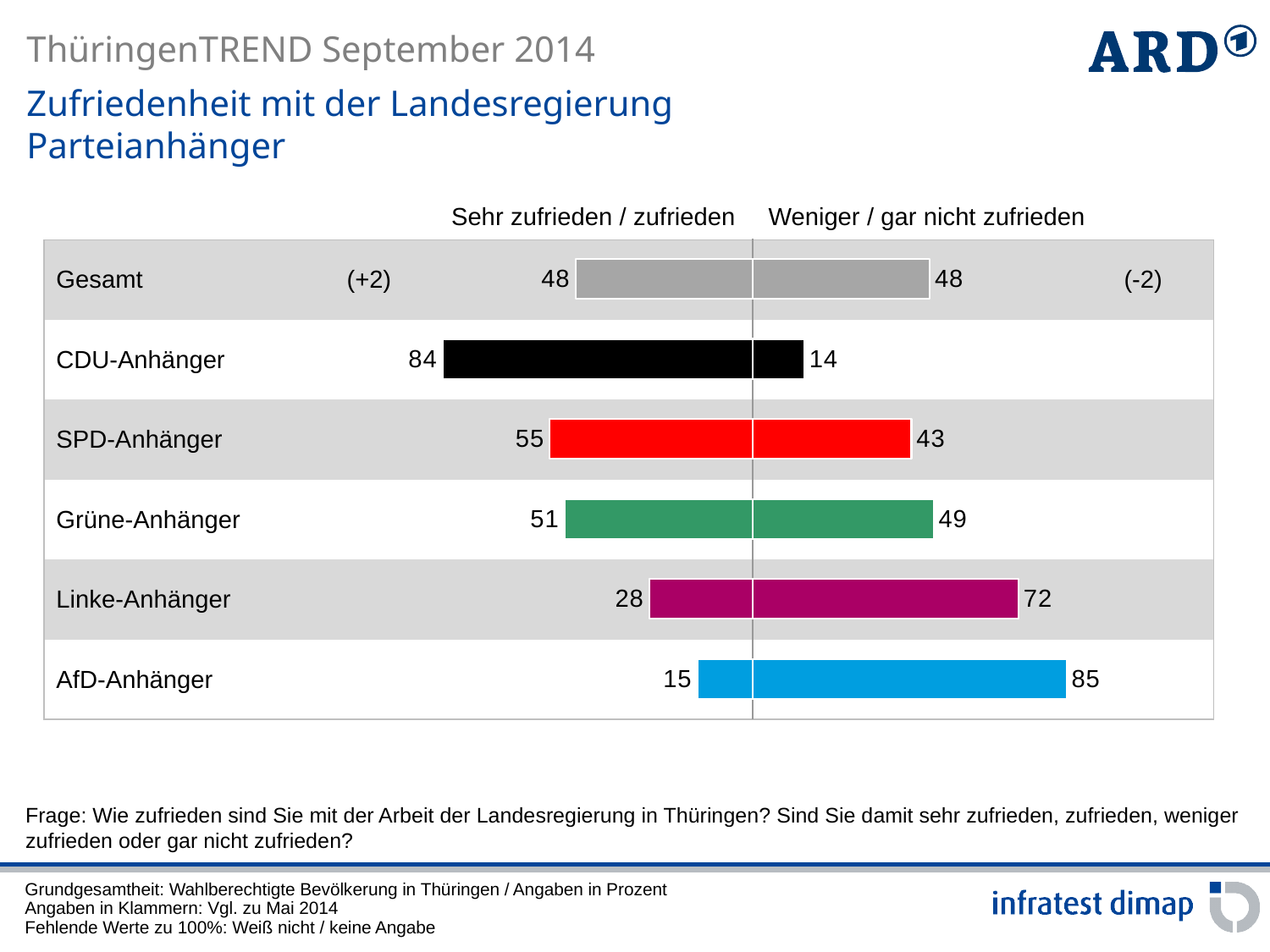
How many series does the chart show? 2 Which is larger: the 'Weniger / gar nicht zufrieden' value for Linke-Anhänger or for SPD-Anhänger? Linke-Anhänger What is the difference between the 'Sehr zufrieden / zufrieden' values for SPD-Anhänger and Grüne-Anhänger? 4 Which group has the lowest 'Weniger / gar nicht zufrieden' value? CDU-Anhänger What change compared to May 2014 is shown in parentheses for the 'Sehr zufrieden / zufrieden' value of Gesamt? (+2) What is the 'Weniger / gar nicht zufrieden' value for Linke-Anhänger? 72 Which group has the highest 'Sehr zufrieden / zufrieden' value? CDU-Anhänger What is the 'Sehr zufrieden / zufrieden' value for Gesamt? 48 What kind of chart is shown on the slide? Bar chart What is the 'Weniger / gar nicht zufrieden' value for AfD-Anhänger? 85 How many groups (rows) are shown in the chart? 6 What is the 'Sehr zufrieden / zufrieden' value for CDU-Anhänger? 84